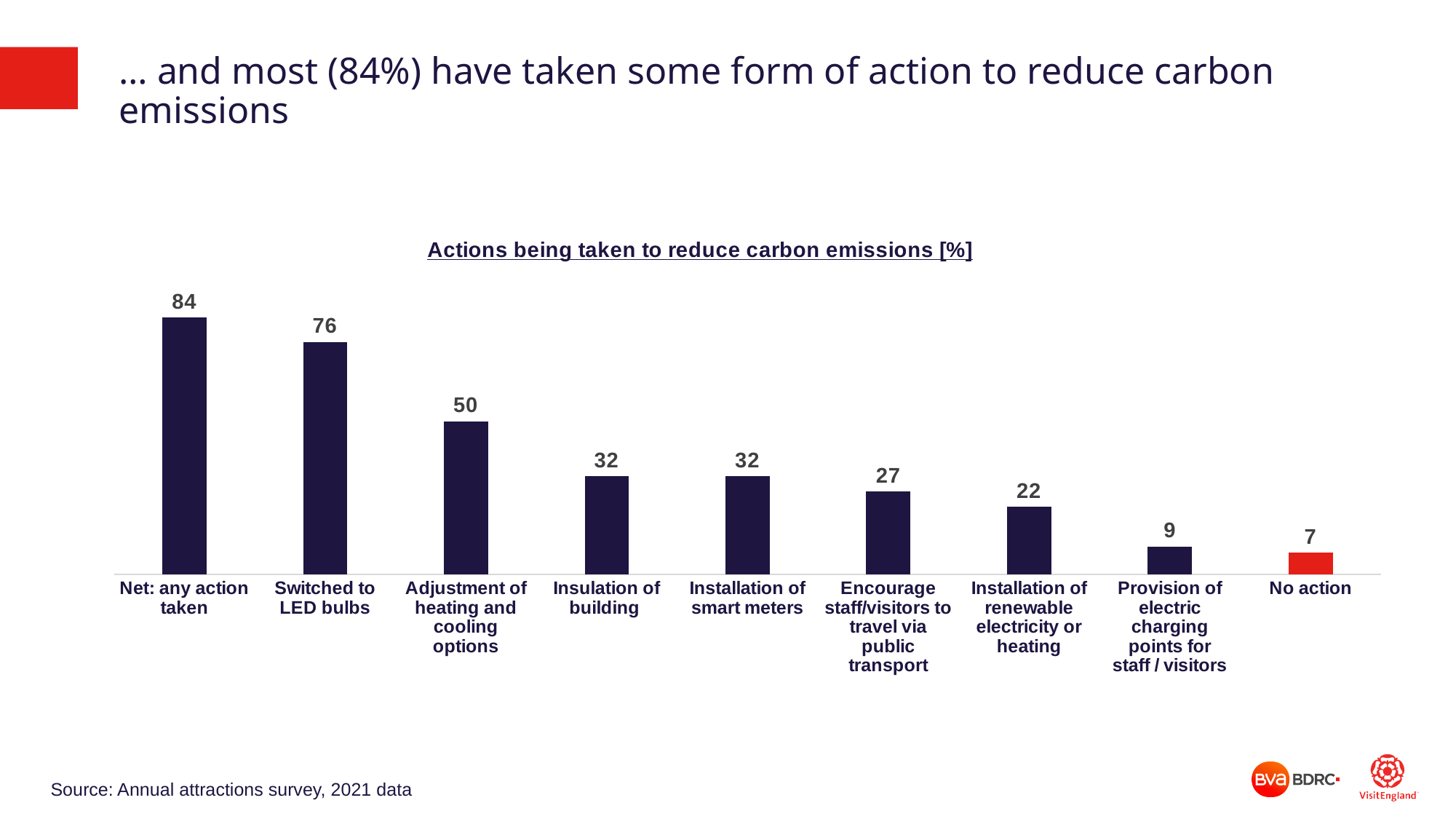
What is the value for Switched to LED bulbs? 76 Do the values rise or fall from left to right across the categories? Fall What is the value for No action? 7 Which is larger: Encourage staff/visitors to travel via public transport or Installation of renewable electricity or heating? Encourage staff/visitors to travel via public transport Which category has the lowest value? No action Which bar is coloured red rather than dark navy? No action Which category has the highest value? Net: any action taken What is the title of the chart? Actions being taken to reduce carbon emissions [%] How many categories are shown on the chart? 9 What kind of chart is this? Bar chart What is the value for Installation of renewable electricity or heating? 22 What is the difference between Switched to LED bulbs and Adjustment of heating and cooling options? 26